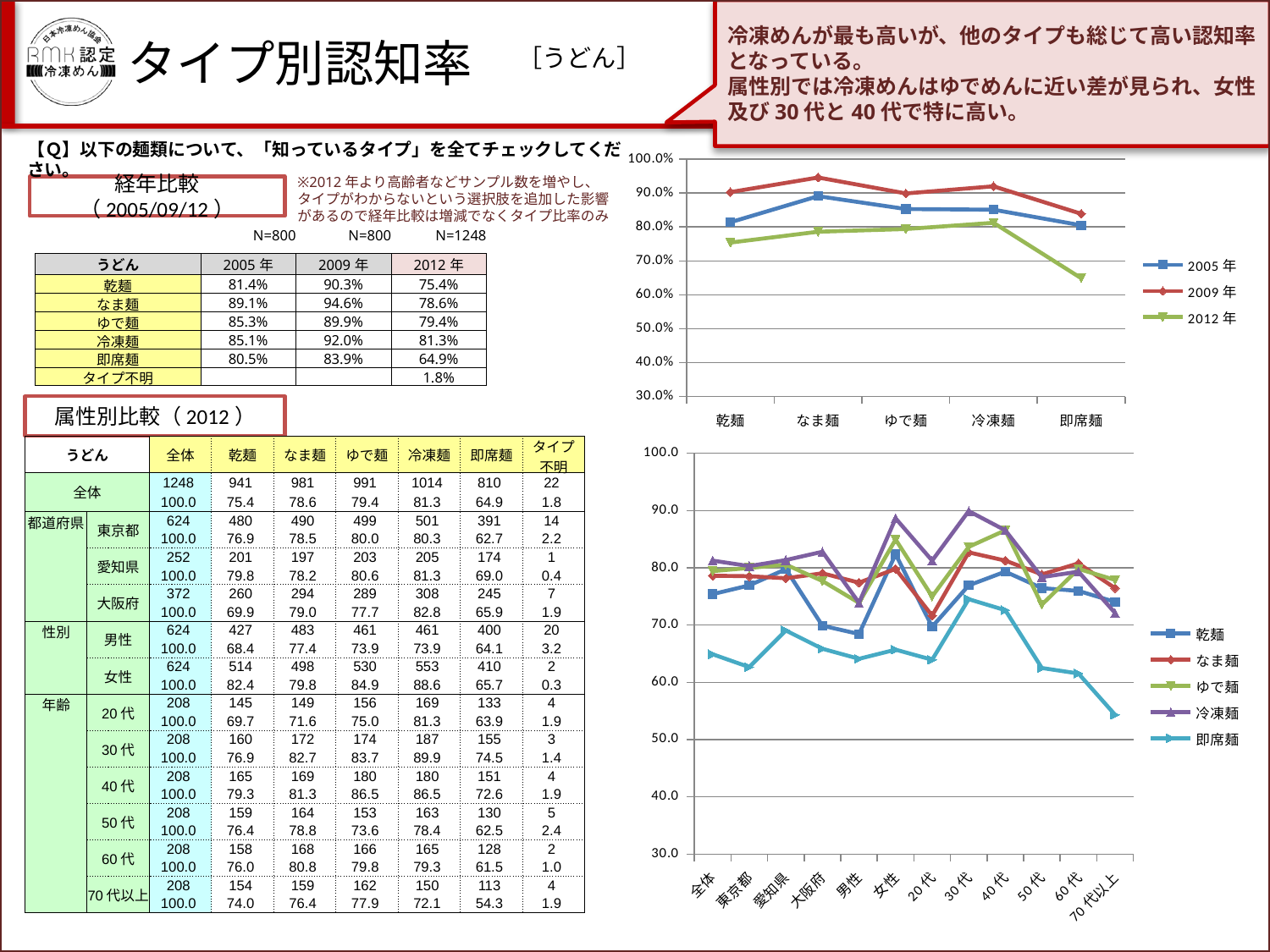
How many categories are shown on the x axis of the upper chart (経年比較)? 5 In the lower chart (属性別比較), which series has the lowest value at 70代以上? 即席麺 How many series does the legend of the upper chart (経年比較) list? 3 In the upper chart (経年比較), which category has the lowest value for the 2012年 series? 即席麺 What kind of chart is the upper chart (経年比較) on the slide? line chart How many series does the legend of the lower chart (属性別比較) list? 5 In the lower chart (属性別比較), which series has the highest value at 30代? 冷凍麺 In the upper chart (経年比較), is the 2009年 value for なま麺 greater or less than 90.0%? greater In the upper chart (経年比較), is the 2012年 value for 即席麺 greater or less than 70.0%? less In the upper chart (経年比較), which is larger at 冷凍麺: the 2005年 value or the 2009年 value? 2009年 How many categories are shown on the x axis of the lower chart (属性別比較)? 12 In the upper chart (経年比較), what is the 2012年 value for 冷凍麺 as given in the accompanying table? 81.3%